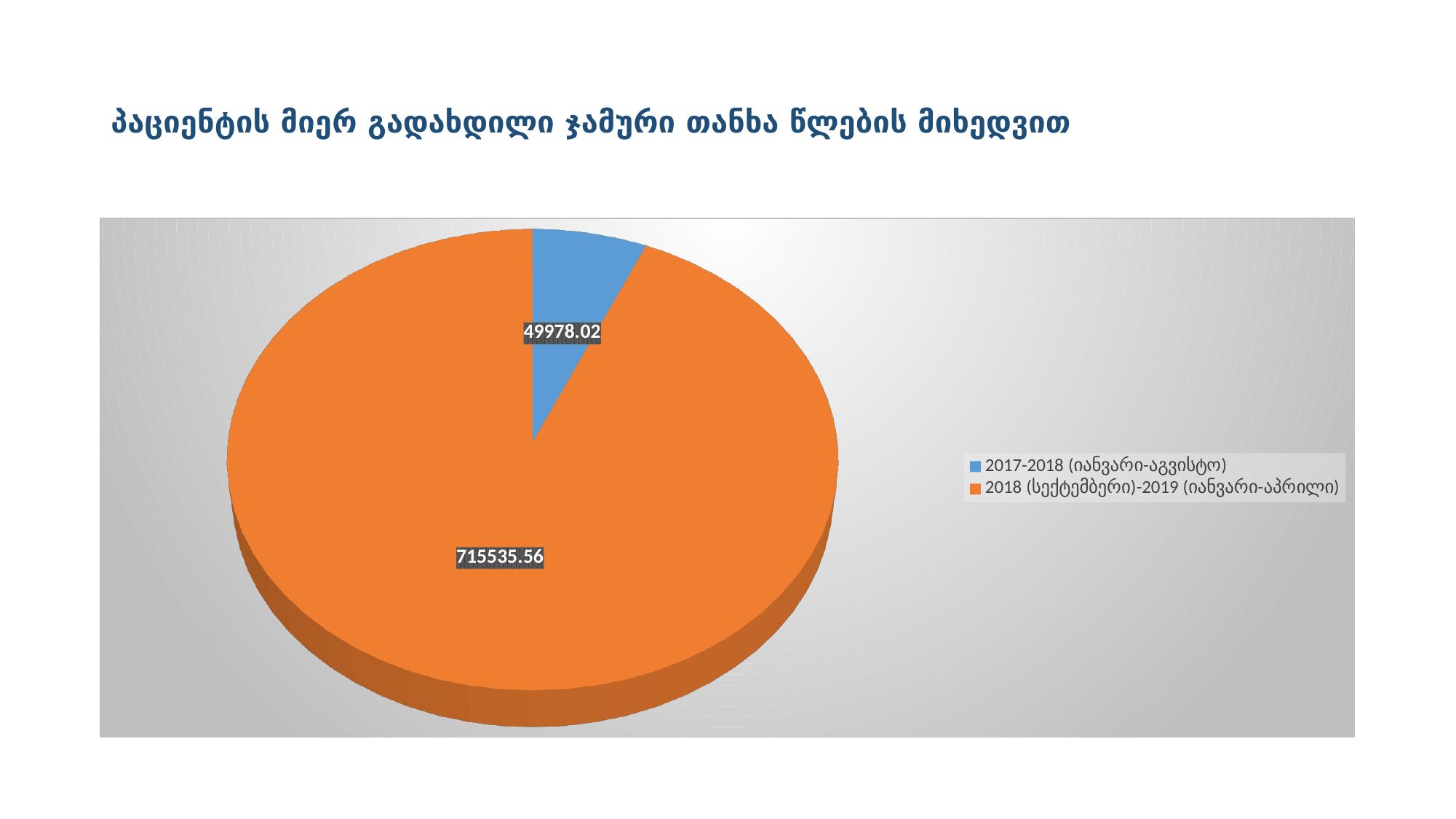
How many entries does the legend list? 2 What is the value for 2018 (სექტემბერი)-2019 (იანვარი-აპრილი)? 715535.56 What type of chart is shown on the slide? pie chart What is the difference between the value for 2018 (სექტემბერი)-2019 (იანვარი-აპრილი) and the value for 2017-2018 (იანვარი-აგვისტო)? 665557.54 What is the value for 2017-2018 (იანვარი-აგვისტო)? 49978.02 Which category has the largest slice of the pie? 2018 (სექტემბერი)-2019 (იანვარი-აპრილი) Which category has the smallest slice of the pie? 2017-2018 (იანვარი-აგვისტო) How many slices does the pie chart have? 2 Which is larger: the value for 2017-2018 (იანვარი-აგვისტო) or the value for 2018 (სექტემბერი)-2019 (იანვარი-აპრილი)? 2018 (სექტემბერი)-2019 (იანვარი-აპრილი) What colour is the slice for 2018 (სექტემბერი)-2019 (იანვარი-აპრილი)? orange What is the total of all slices in the pie chart? 765513.58